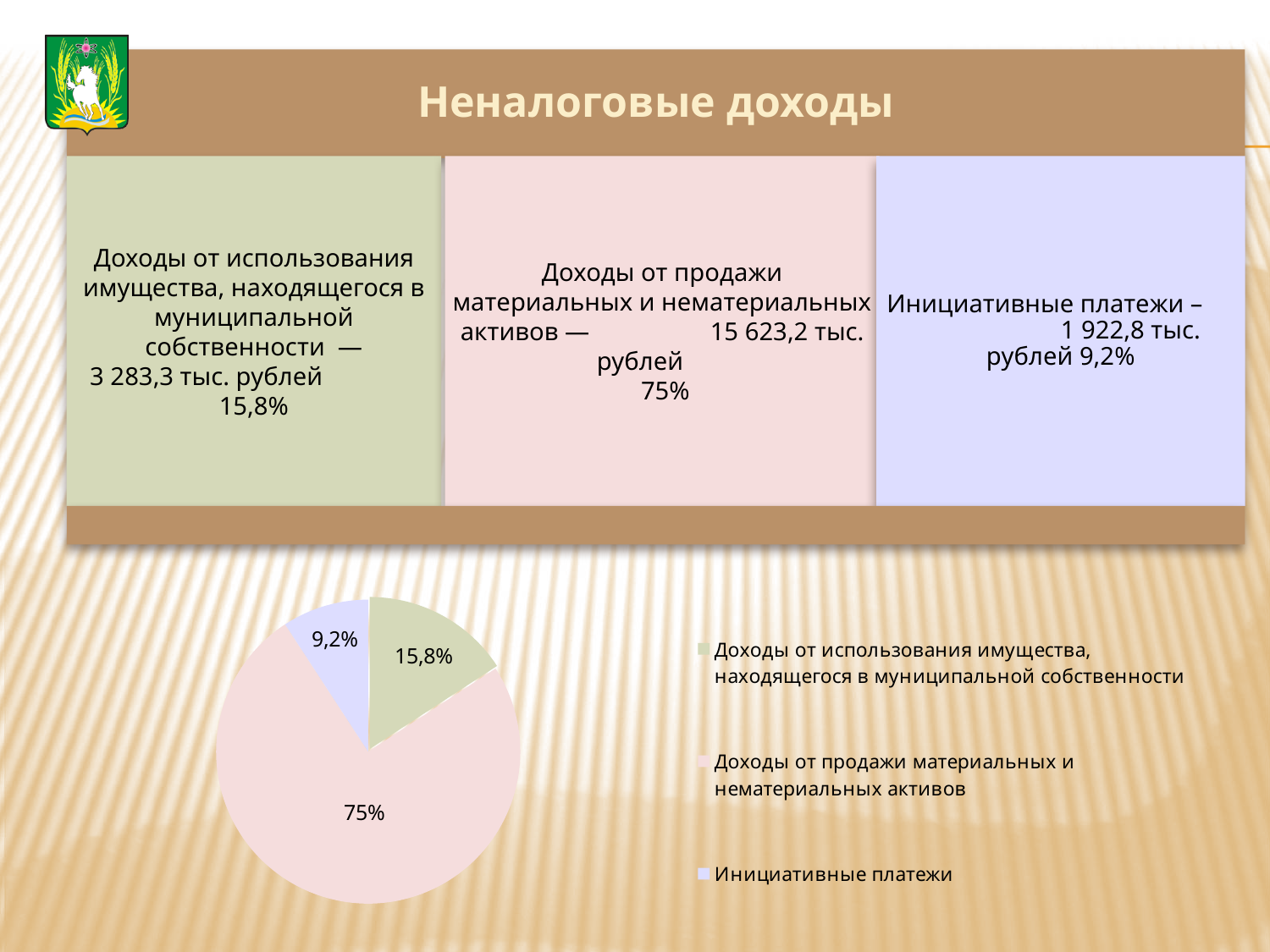
What is the difference in percentage points between the slice for Доходы от продажи материальных и нематериальных активов and the slice for Инициативные платежи? 65,8 What colour is the slice for Инициативные платежи in the pie chart? light purple Which category has the largest slice in the pie chart? Доходы от продажи материальных и нематериальных активов How many slices does the pie chart have? 3 Which category has the smallest slice in the pie chart? Инициативные платежи What is the difference in percentage points between the slice for Доходы от использования имущества, находящегося в муниципальной собственности and the slice for Инициативные платежи? 6,6 How many entries does the legend of the pie chart list? 3 What share of the pie is labelled for Инициативные платежи? 9,2% What share of the pie is labelled for Доходы от продажи материальных и нематериальных активов? 75% What kind of chart is shown on the slide? pie chart What share of the pie is labelled for Доходы от использования имущества, находящегося в муниципальной собственности? 15,8% Which slice is larger: Доходы от использования имущества, находящегося в муниципальной собственности or Инициативные платежи? Доходы от использования имущества, находящегося в муниципальной собственности